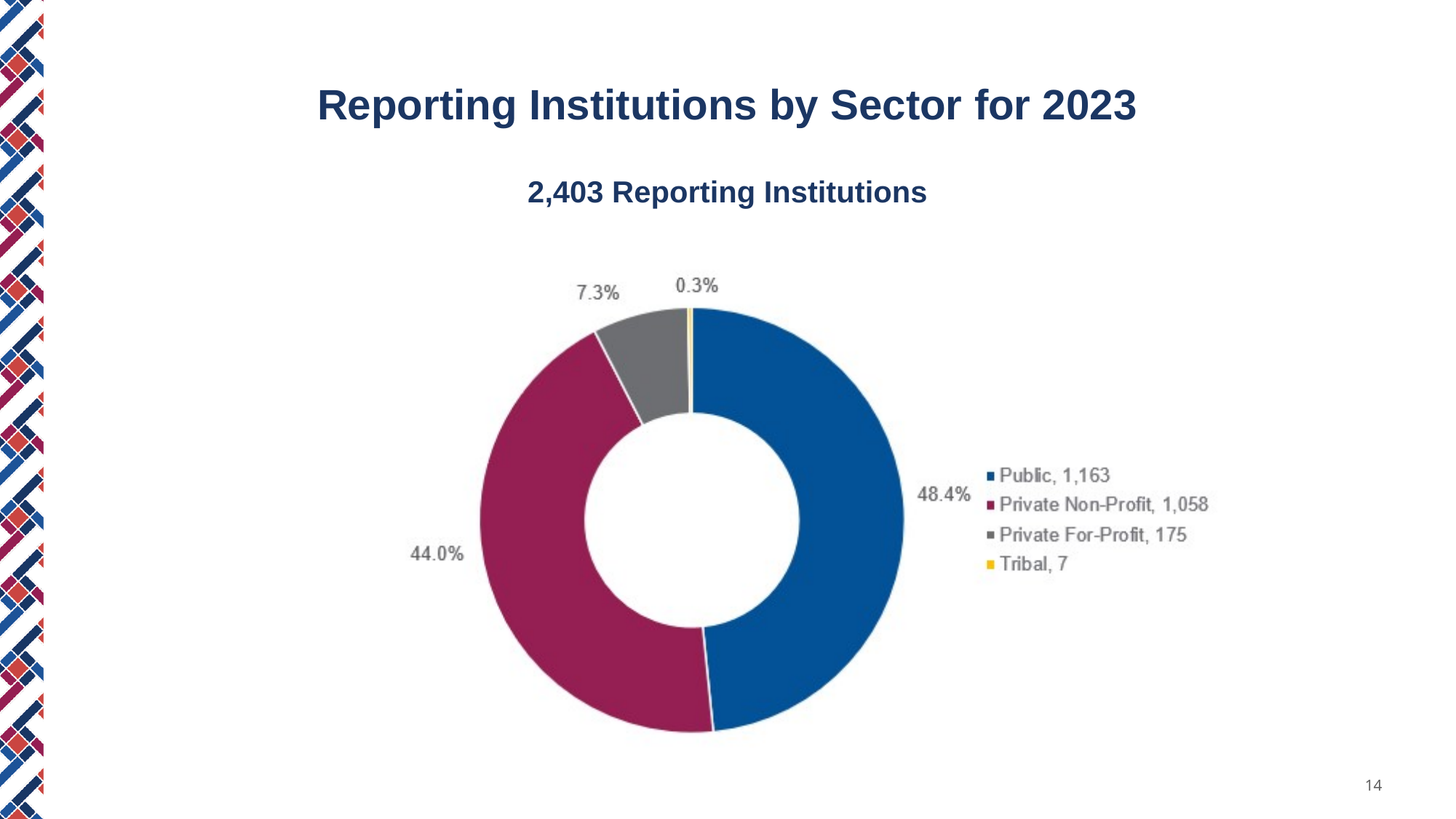
What is the total number of reporting institutions shown on the slide? 2,403 Which sector has the fewest reporting institutions? Tribal Which sector has the most reporting institutions? Public How many reporting institutions are Tribal? 7 What share of reporting institutions is Private For-Profit? 7.3% How many reporting institutions are Private Non-Profit? 1,058 What is the difference between the number of Public and Private Non-Profit reporting institutions? 105 How many reporting institutions are in the Public sector? 1,163 How many sectors are shown in the chart? 4 What share of reporting institutions is Public? 48.4% What kind of chart is shown on the slide? Pie chart (doughnut) Which has more reporting institutions, Private For-Profit or Tribal? Private For-Profit